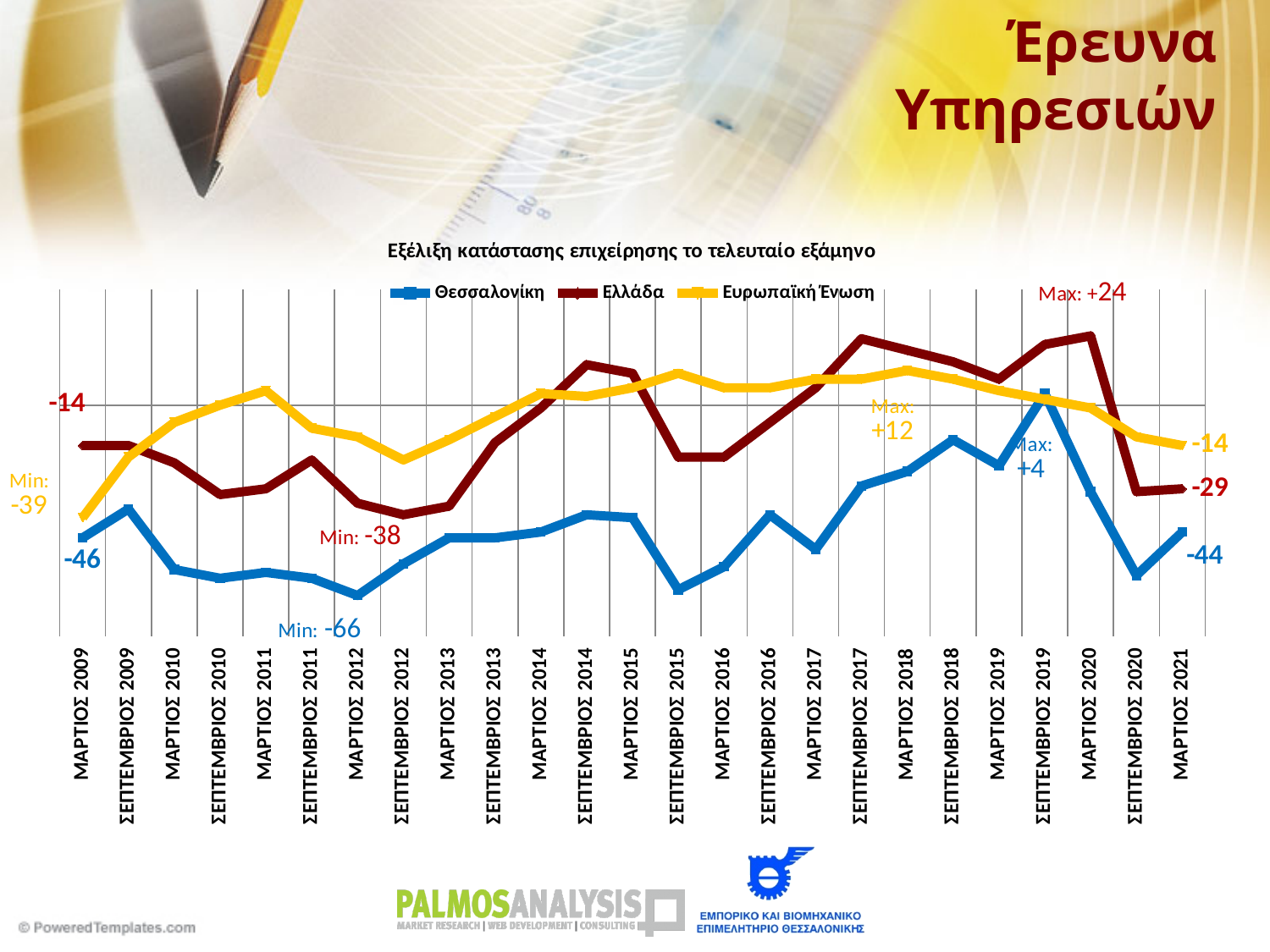
What is the value for Ευρωπαϊκή Ένωση in ΜΑΡΤΙΟΣ 2021? -14 In ΜΑΡΤΙΟΣ 2021, which is higher: Ελλάδα or Θεσσαλονίκη? Ελλάδα How many series does the legend list? 3 What is the minimum value reached by the Θεσσαλονίκη series? -66 What is the value for Θεσσαλονίκη in ΜΑΡΤΙΟΣ 2009? -46 What is the maximum value reached by the Θεσσαλονίκη series? +4 What is the value for Ελλάδα in ΜΑΡΤΙΟΣ 2021? -29 What kind of chart is shown on the slide? Line chart What is the difference between the Θεσσαλονίκη values in ΜΑΡΤΙΟΣ 2021 and ΜΑΡΤΙΟΣ 2009? 2 What is the maximum value reached by the Ελλάδα series? +24 In which period does the Θεσσαλονίκη series reach its minimum? ΜΑΡΤΙΟΣ 2012 Which series are listed in the legend? Θεσσαλονίκη, Ελλάδα, Ευρωπαϊκή Ένωση